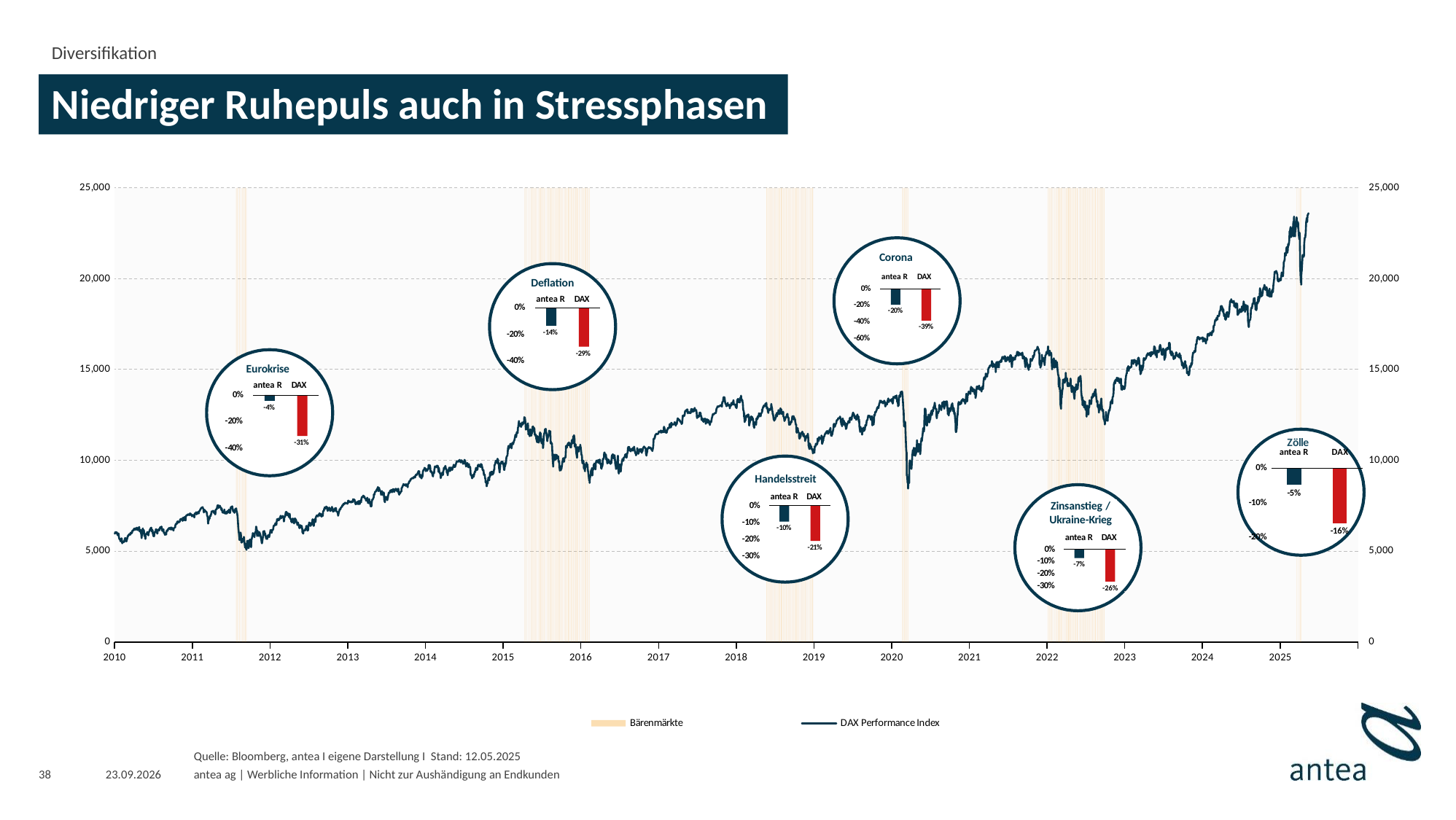
In the Deflation inset chart, what is the difference between the DAX value and the antea R value? 15 percentage points How many inset bar charts comparing antea R and DAX are shown on the slide? 6 What kind of chart is the main chart showing the DAX Performance Index from 2010 to 2025? Line chart In the Handelsstreit inset chart, which has the larger decline, antea R or DAX? DAX In the Zölle inset chart, what is the value shown for DAX? -16% In the Eurokrise inset chart, what is the value shown for DAX? -31% In the Eurokrise inset chart, what is the value shown for antea R? -4% In the main chart, is the DAX Performance Index value at the start of 2010 greater or less than 10,000? less In the Corona inset chart, what is the value shown for antea R? -20% In the Zinsanstieg / Ukraine-Krieg inset chart, what is the value shown for antea R? -7% In the Corona inset chart, what is the value shown for DAX? -39% Across the six inset charts, which stress phase shows the largest DAX decline? Corona